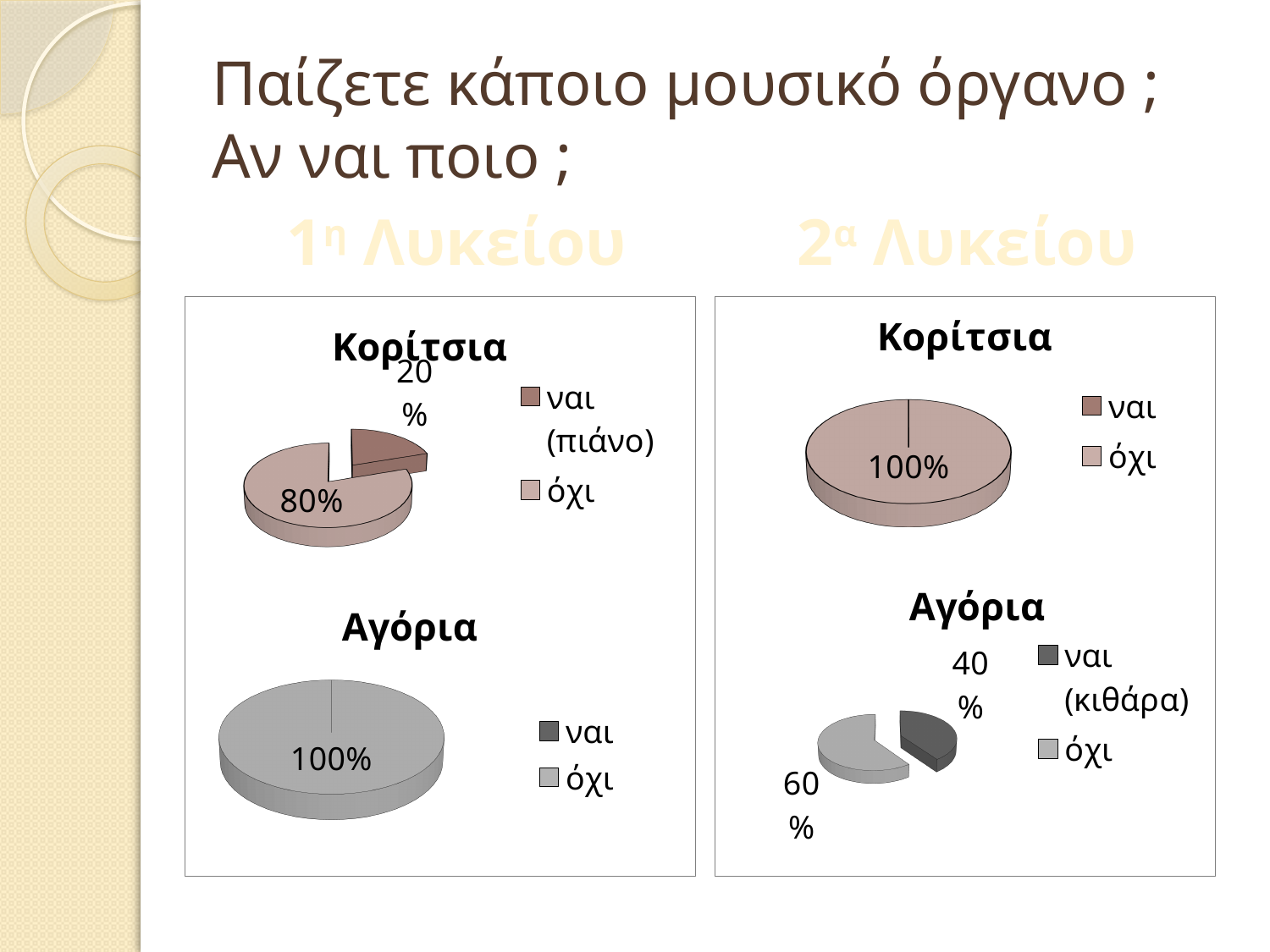
What type of chart is used for the Αγόρια chart in the 1η Λυκείου panel (bottom left)? pie chart In the 1η Λυκείου Κορίτσια pie chart (top left), what share is labelled for the 'όχι' slice? 80% In the 1η Λυκείου Αγόρια pie chart (bottom left), what percentage is printed on the pie? 100% In the 2α Λυκείου Αγόρια pie chart (bottom right), what share is labelled for the 'ναι (κιθάρα)' slice? 40% In the 2α Λυκείου Κορίτσια pie chart (top right), what percentage is printed on the pie? 100% In the 1η Λυκείου Κορίτσια pie chart (top left), which slice is larger, 'ναι (πιάνο)' or 'όχι'? όχι How many entries does the legend of the 2α Λυκείου Κορίτσια pie chart (top right) list? 2 In the 2α Λυκείου Αγόρια pie chart (bottom right), what is the difference in percentage points between the 'όχι' and 'ναι (κιθάρα)' slices? 20 In the 1η Λυκείου Κορίτσια pie chart (top left), what share is labelled for the 'ναι (πιάνο)' slice? 20% In the 2α Λυκείου Αγόρια pie chart (bottom right), what share is labelled for the 'όχι' slice? 60% In the 1η Λυκείου Κορίτσια pie chart (top left), what is the difference in percentage points between the 'όχι' and 'ναι (πιάνο)' slices? 60 In the 2α Λυκείου Αγόρια pie chart (bottom right), which slice is the smallest? ναι (κιθάρα)